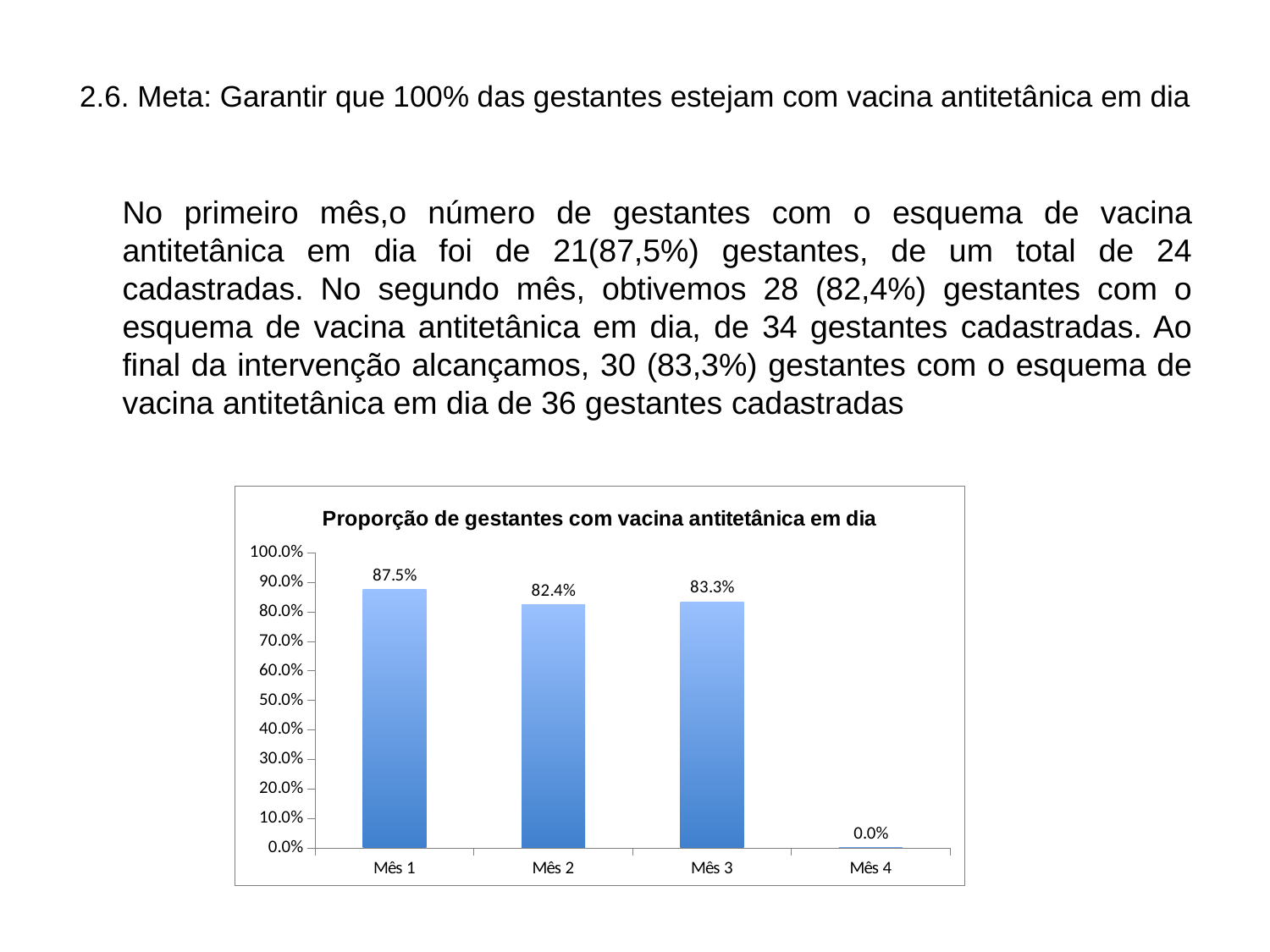
What is the value for Mês 4? 0.0% Which is larger, the value for Mês 1 or the value for Mês 3? Mês 1 What kind of chart is shown? bar chart Which month has the highest proportion? Mês 1 Is the value for Mês 2 greater or less than 90.0%? less Which month has the lowest proportion? Mês 4 What is the difference between the values for Mês 1 and Mês 2? 5.1% What is the title of the chart? Proporção de gestantes com vacina antitetânica em dia How many categories are shown on the x axis? 4 What is the value for Mês 1? 87.5% What is the value for Mês 2? 82.4% What is the value for Mês 3? 83.3%